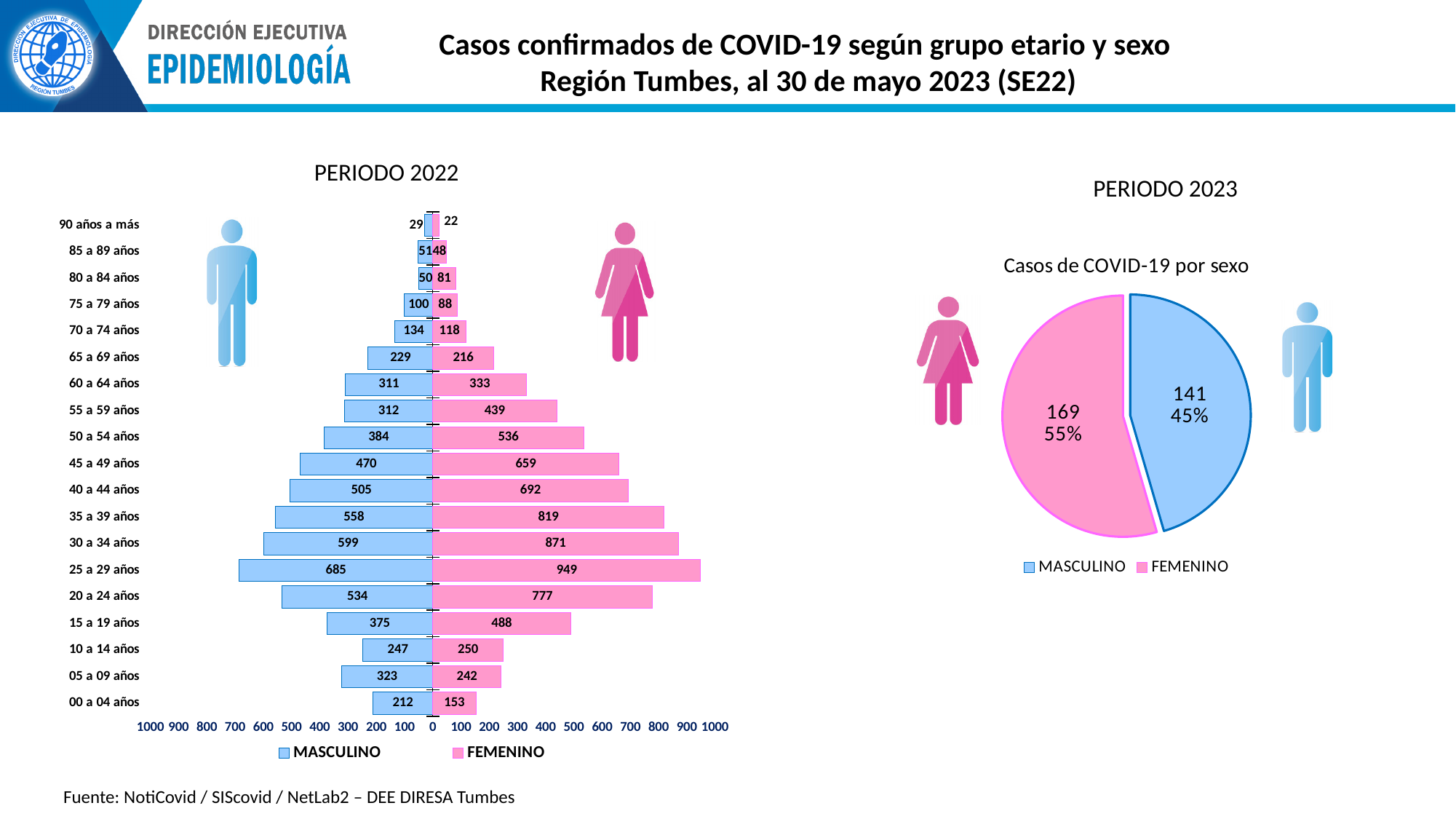
In the PERIODO 2023 pie chart, what share of cases is MASCULINO? 45% In the PERIODO 2022 chart, what is the difference between the FEMENINO and MASCULINO values for the 45 a 49 años age group? 189 In the PERIODO 2023 pie chart, how many cases are FEMENINO? 169 What kind of chart is the PERIODO 2022 chart? Bar chart In the PERIODO 2022 chart, which age group has the highest FEMENINO value? 25 a 29 años What kind of chart is the PERIODO 2023 chart? Pie chart In the PERIODO 2022 chart, which is larger for the 05 a 09 años age group, MASCULINO or FEMENINO? MASCULINO In the PERIODO 2022 chart, what is the MASCULINO value for the 25 a 29 años age group? 685 In the PERIODO 2022 chart, which age group has the lowest FEMENINO value? 90 años a más In the PERIODO 2022 chart, what is the FEMENINO value for the 30 a 34 años age group? 871 How many series does the legend of the PERIODO 2022 chart list? 2 How many age groups are shown in the PERIODO 2022 chart? 19